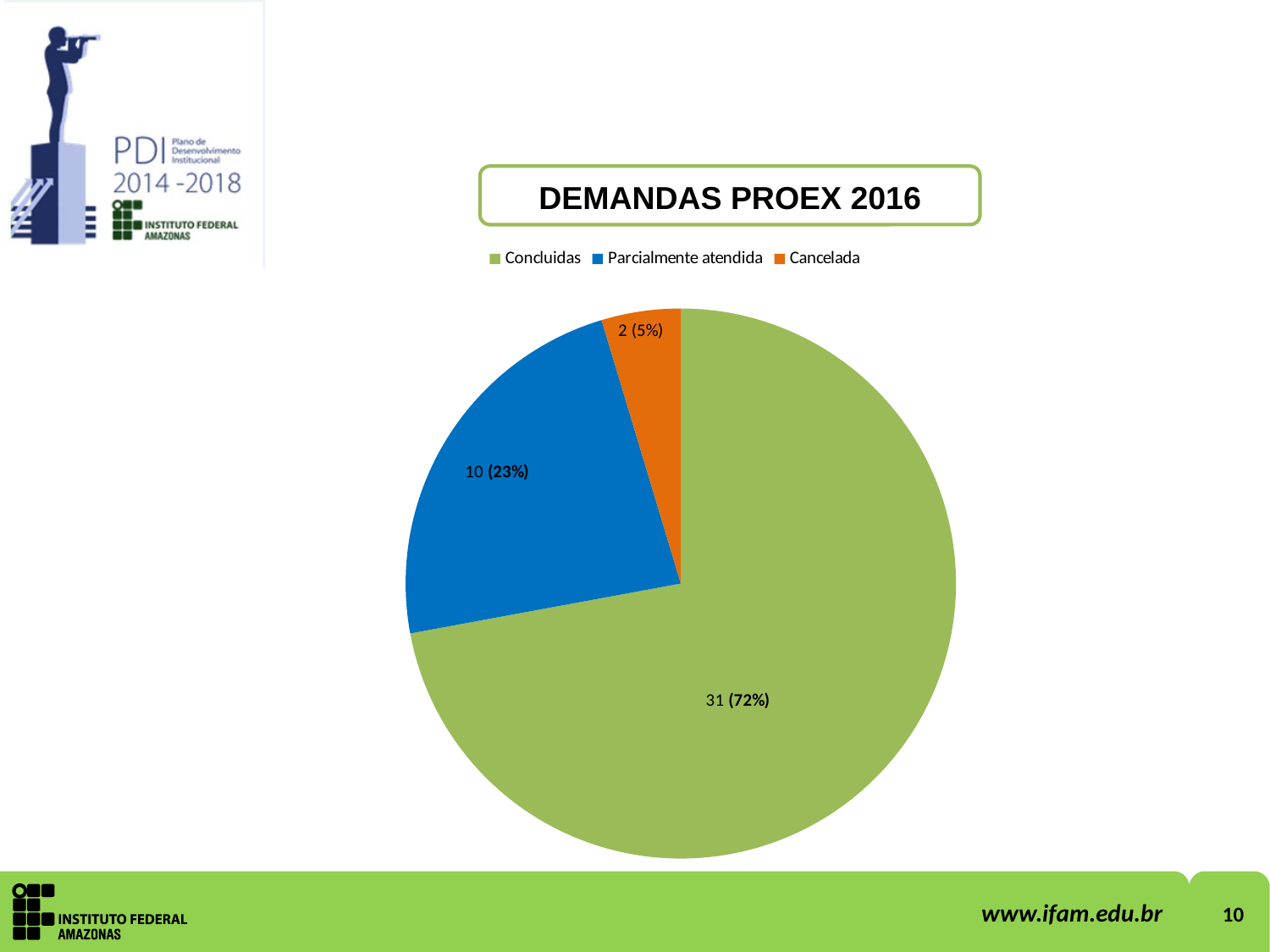
Which category has the largest slice? Concluidas How many slices does the pie chart have? 3 What is the title of the chart? DEMANDAS PROEX 2016 How many entries does the legend list? 3 Which category has the smallest slice? Cancelada What is the value for Cancelada? 2 What share of the pie does Cancelada represent? 5% What type of chart is shown on the slide? pie chart What share of the pie does Concluidas represent? 72% What is the value for Concluidas? 31 What is the difference between the values for Concluidas and Parcialmente atendida? 21 What is the value for Parcialmente atendida? 10